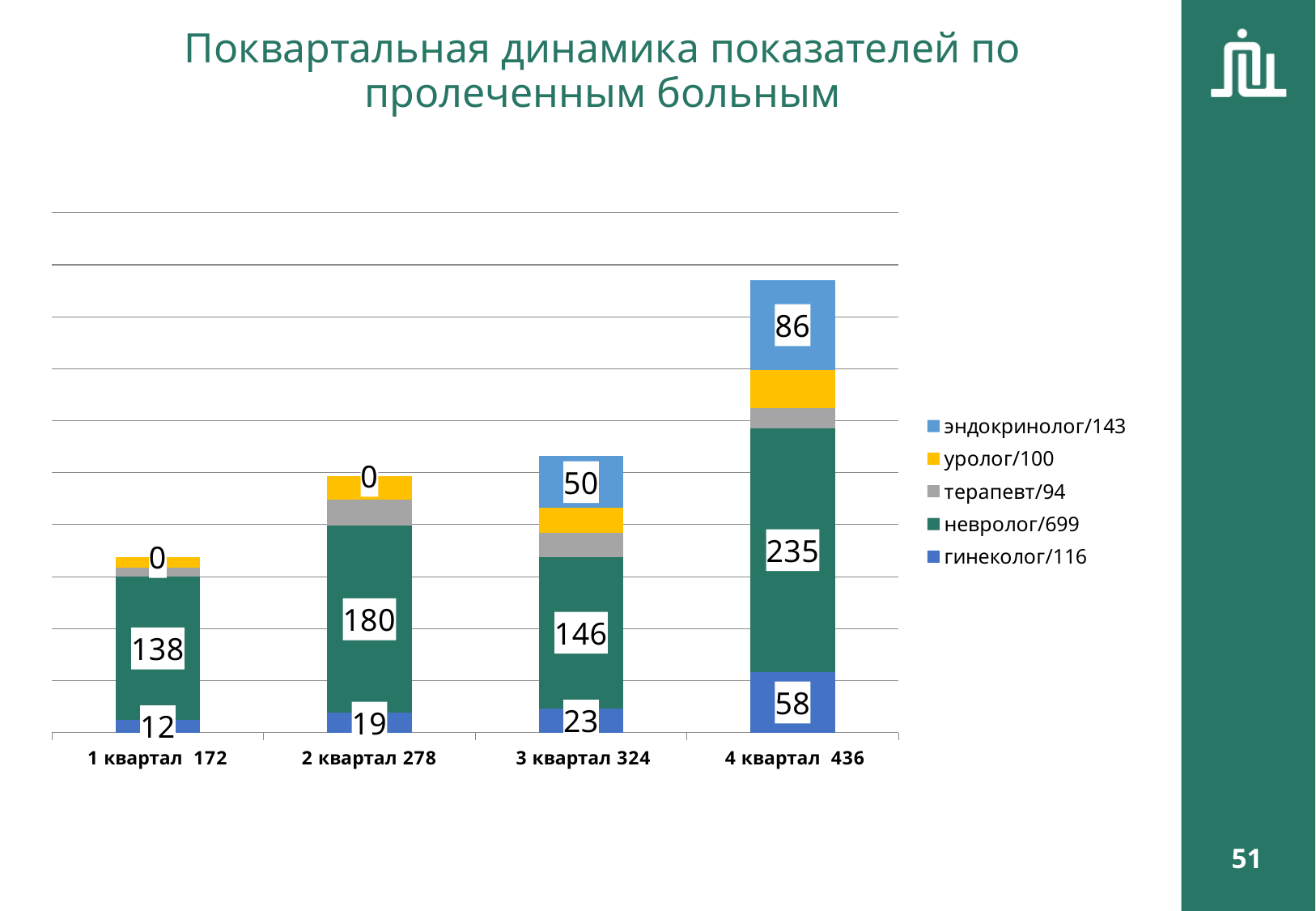
What is the value for гинеколог in 2 квартал? 19 How many series does the legend list? 5 In which quarter is the гинеколог value lowest? 1 квартал What is the difference between the невролог values in 4 квартал and 3 квартал? 89 What total is shown for невролог in the legend? 699 Which is larger: the невролог value in 2 квартал or in 3 квартал? 2 квартал How many quarters (categories) are shown on the x axis? 4 What type of chart is shown on the slide? stacked bar chart Do the гинеколог values rise or fall from 1 квартал to 4 квартал? rise What is the value for невролог in 4 квартал? 235 What is the value for эндокринолог in 3 квартал? 50 In which quarter is the невролог value highest? 4 квартал